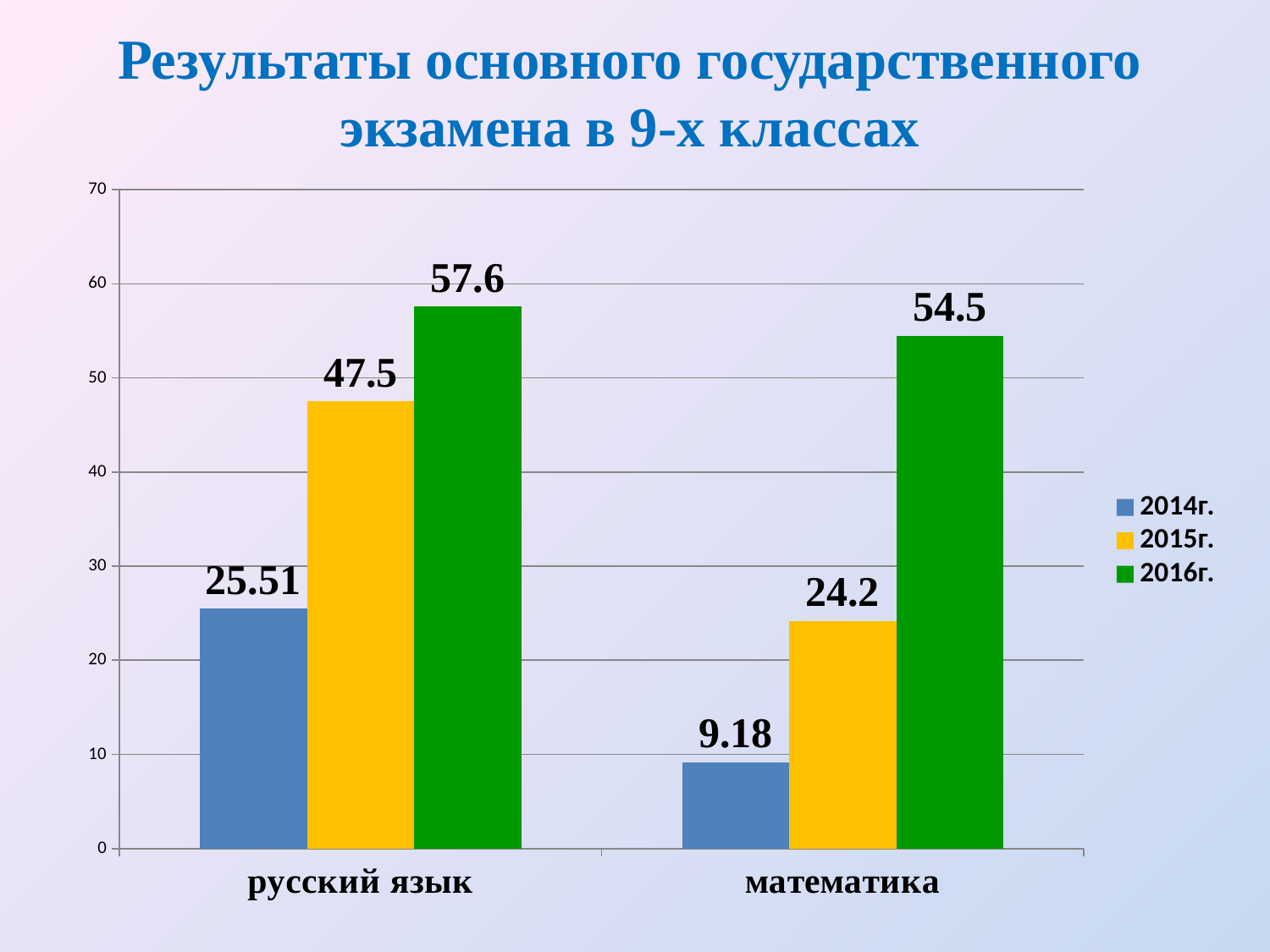
What is the difference between the 2016г. and 2015г. values for математика? 30.3 What kind of chart is shown on the slide? bar chart How many series does the legend list? 3 Which is larger: the 2014г. value for русский язык or the 2015г. value for математика? 2014г. value for русский язык Do the values for русский язык rise or fall from 2014г. to 2016г.? rise Which series has the lowest value in the русский язык category? 2014г. Which series has the highest value in the математика category? 2016г. What is the value for 2015г. in the русский язык category? 47.5 What is the value for 2016г. in the русский язык category? 57.6 How many categories are shown on the x axis? 2 Is the 2016г. value for математика greater or less than 50? greater What is the value for 2014г. in the математика category? 9.18